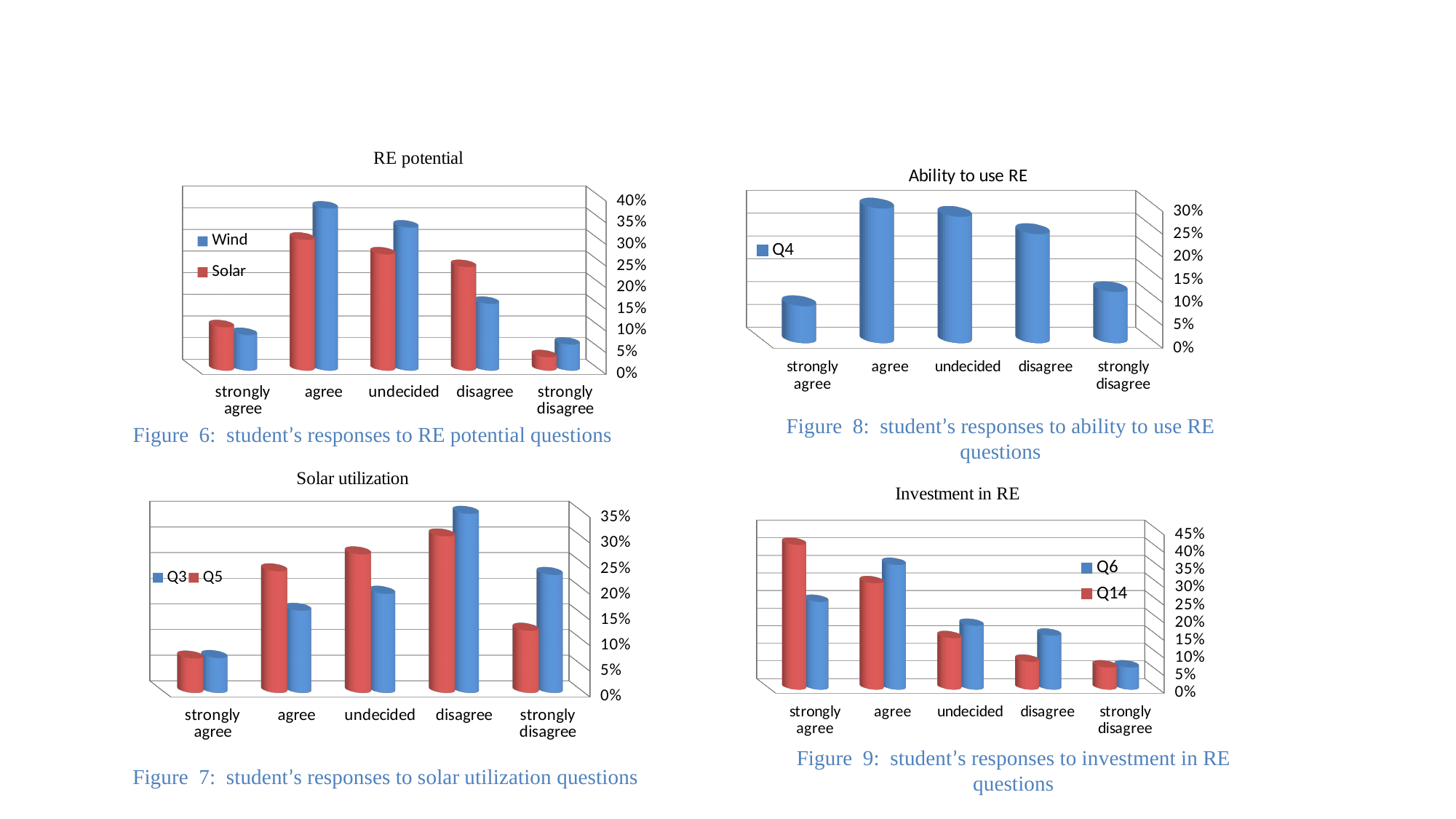
In the 'RE potential' chart, which is larger for 'disagree': Wind or Solar? Solar In the 'Solar utilization' chart, which category has the highest Q3 value? disagree In the 'RE potential' chart, which category has the highest Wind value? agree What kind of chart is the 'Investment in RE' chart? bar chart In the 'RE potential' chart, is the Wind value for 'agree' greater or less than 30%? greater In the 'Solar utilization' chart, which is larger for 'strongly disagree': Q3 or Q5? Q3 How many series does the legend of the 'RE potential' chart list? 2 In the 'Investment in RE' chart, which category has the highest Q14 value? strongly agree In the 'Investment in RE' chart, is the Q14 value for 'strongly agree' greater or less than 35%? greater In the 'Ability to use RE' chart, is the value for 'disagree' greater or less than 20%? greater How many categories are shown on the x axis of the 'Ability to use RE' chart? 5 In the 'Ability to use RE' chart, which category has the lowest value? strongly agree